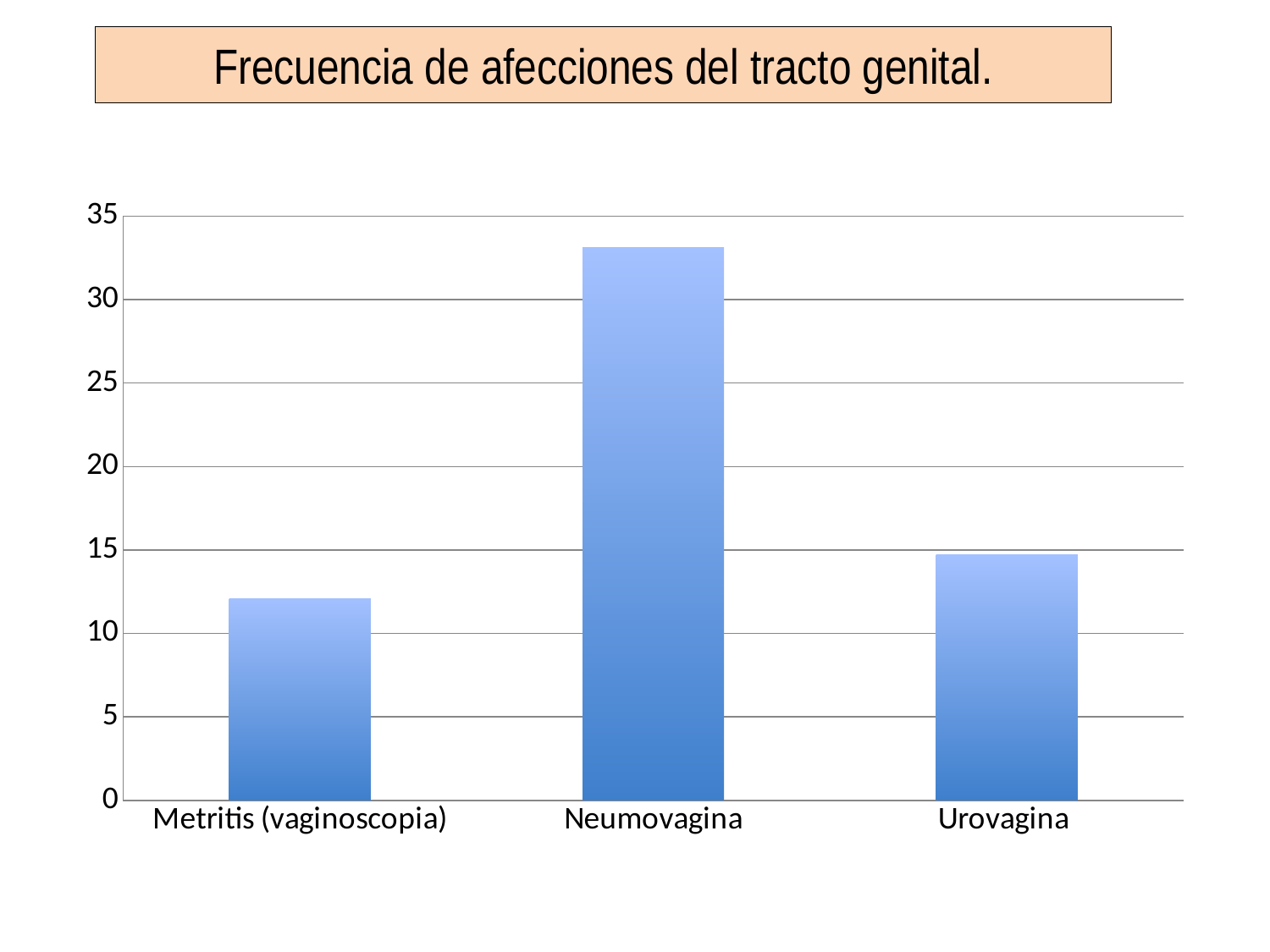
Which is larger, the value for Urovagina or the value for Metritis (vaginoscopia)? Urovagina Which category has the lowest value? Metritis (vaginoscopia) What is the highest value shown on the vertical axis? 35 What kind of chart is shown on the slide? bar chart What is the title shown above the chart? Frecuencia de afecciones del tracto genital. Is the value for Urovagina greater or less than 10? greater Which is larger, the value for Neumovagina or the value for Urovagina? Neumovagina Which category has the highest value? Neumovagina Is the value for Metritis (vaginoscopia) greater or less than 10? greater Is the value for Neumovagina greater or less than 30? greater How many categories are shown on the x axis? 3